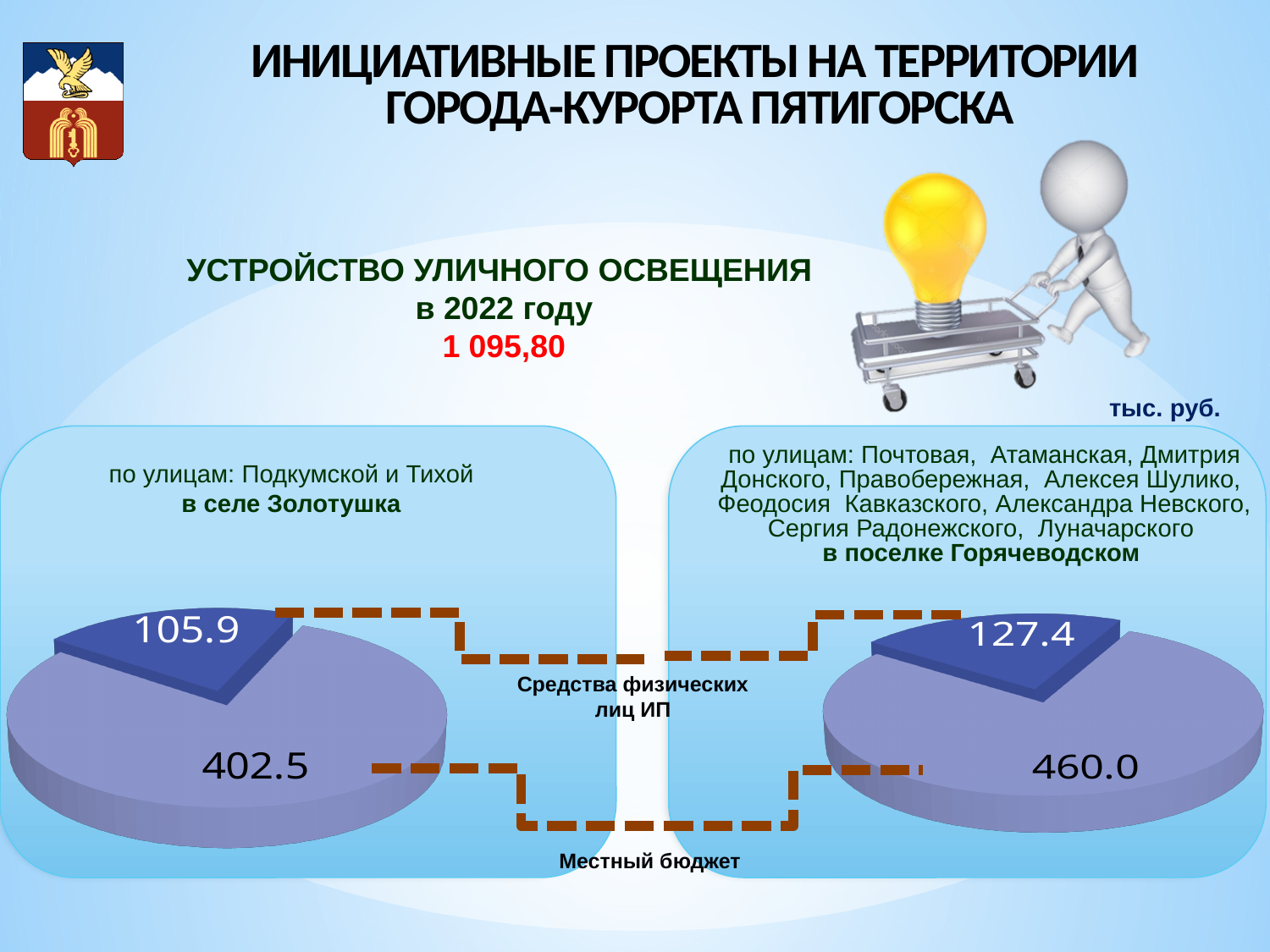
In the left pie chart (село Золотушка), what is the value for Местный бюджет? 402.5 In the right pie chart (поселок Горячеводский), what is the value for Местный бюджет? 460.0 In the left pie chart (село Золотушка), which slice is the largest? Местный бюджет In the right pie chart (поселок Горячеводский), what is the difference between Местный бюджет and Средства физических лиц ИП? 332.6 In the left pie chart (село Золотушка), what is the value for Средства физических лиц ИП? 105.9 In the right pie chart (поселок Горячеводский), what is the value for Средства физических лиц ИП? 127.4 What is the total of the two slices in the right pie chart (поселок Горячеводский)? 587.4 In the left pie chart (село Золотушка), what is the difference between Местный бюджет and Средства физических лиц ИП? 296.6 Which is larger: Местный бюджет in the left pie chart (село Золотушка) or Местный бюджет in the right pie chart (поселок Горячеводский)? поселок Горячеводский (460.0) In the right pie chart (поселок Горячеводский), which slice is the smallest? Средства физических лиц ИП What kind of chart is used on the left side of the slide for село Золотушка? pie chart How many slices does each pie chart on the slide have? 2